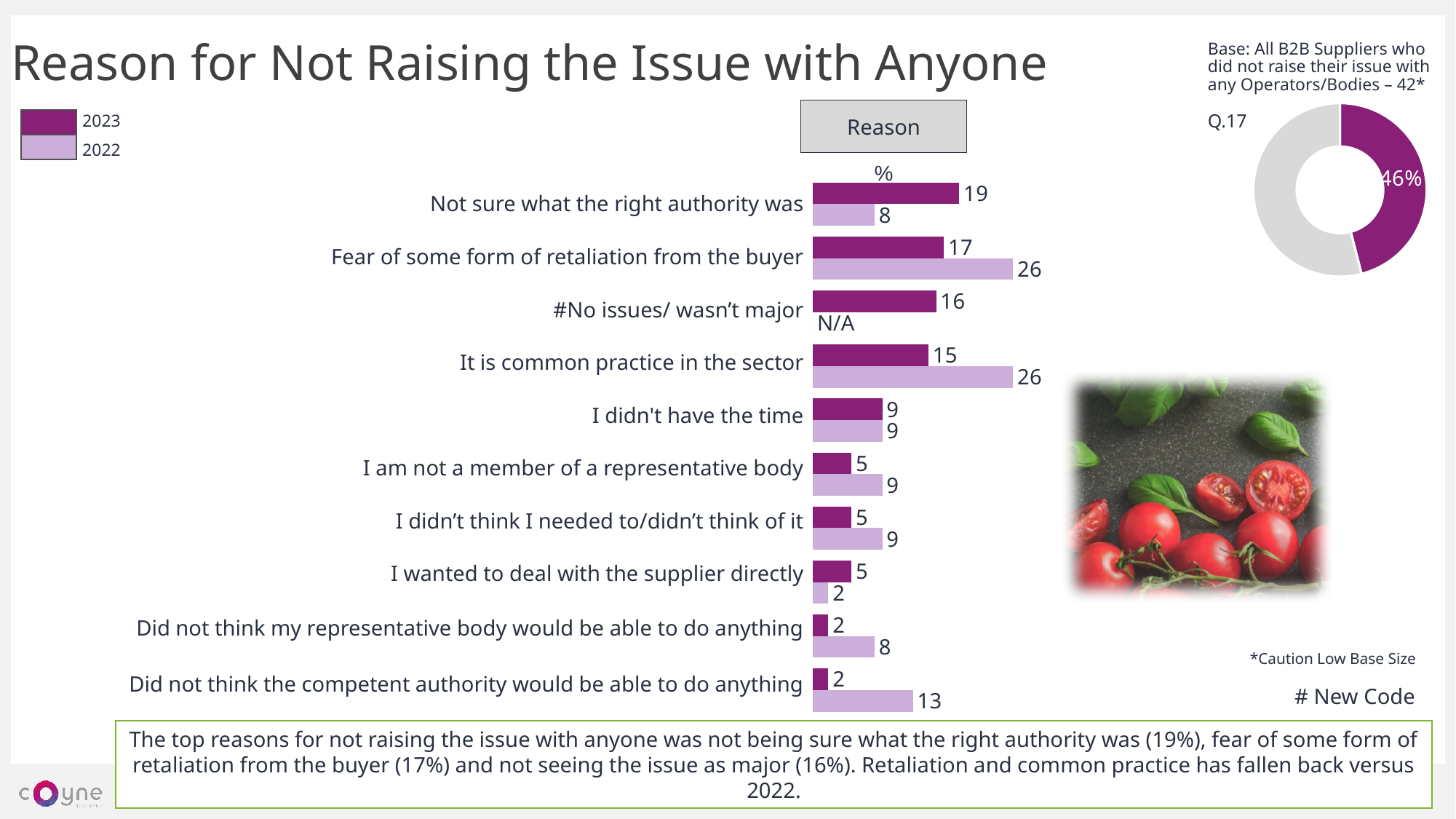
What percentage is shown on the donut chart in the top right of the slide? 46% In the bar chart, what is the difference between the 2022 and 2023 values for "It is common practice in the sector"? 11 In the bar chart, what is the 2022 value for "Fear of some form of retaliation from the buyer"? 26 What type of chart is used to show the reasons for not raising the issue? Bar chart In the bar chart, what is the difference between the 2023 and 2022 values for "Did not think my representative body would be able to do anything"? 6 In the bar chart, which reason has the highest 2023 value? Not sure what the right authority was In the bar chart, what is the 2022 value shown for "#No issues/ wasn't major"? N/A How many reasons (categories) are listed in the bar chart? 10 In the bar chart, for "Did not think the competent authority would be able to do anything", which year has the larger value, 2023 or 2022? 2022 How many series does the legend of the bar chart list? 2 In the bar chart, what is the 2023 value for "I wanted to deal with the supplier directly"? 5 In the bar chart, what is the 2023 value for "Not sure what the right authority was"? 19